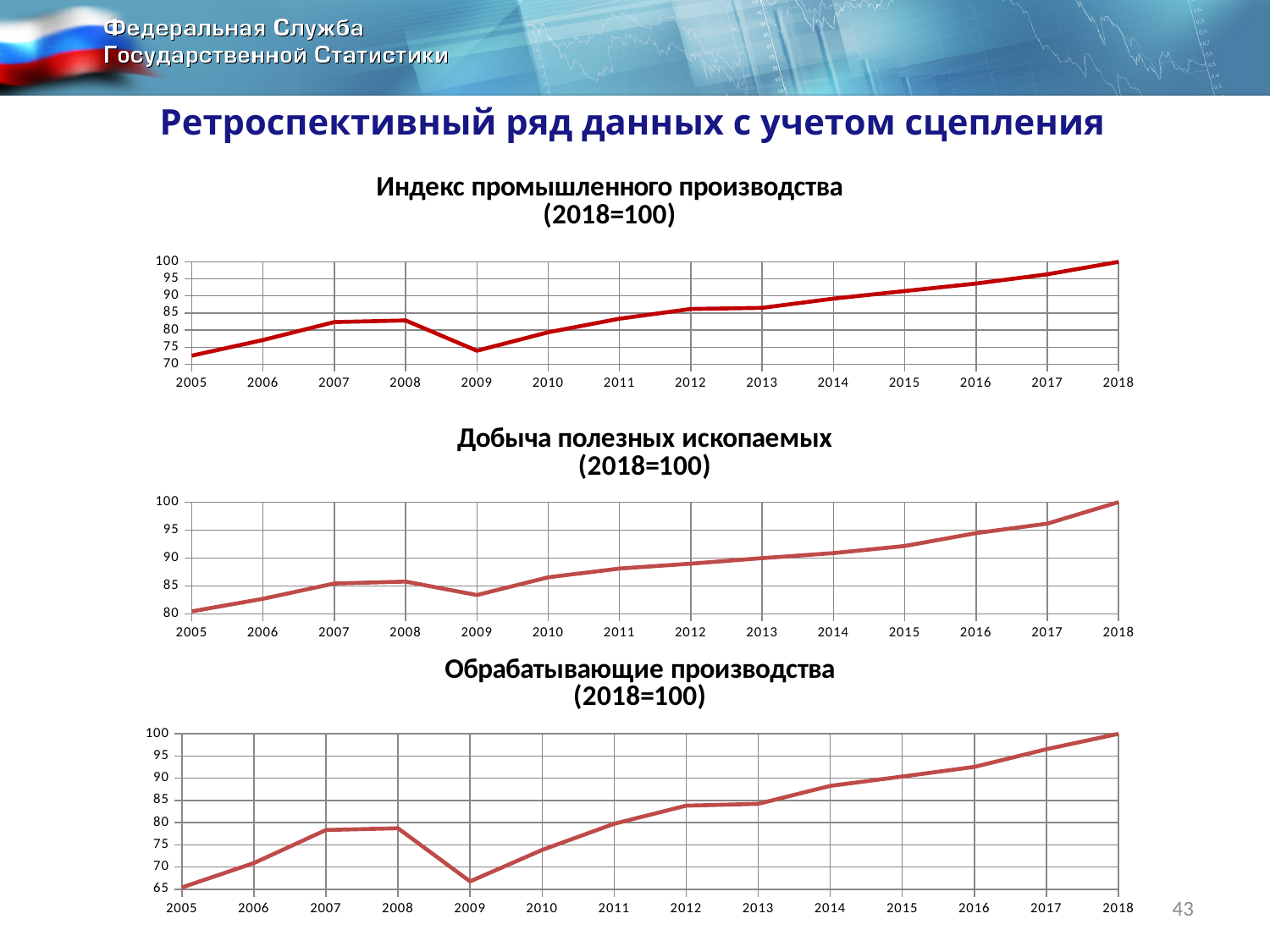
In the top chart "Индекс промышленного производства (2018=100)", is the value for 2009 greater or less than 80? less In the middle chart "Добыча полезных ископаемых (2018=100)", which year has the lowest value? 2005 In the top chart "Индекс промышленного производства (2018=100)", is the value for 2016 greater or less than 90? greater In the bottom chart "Обрабатывающие производства (2018=100)", do the values overall rise or fall from 2005 to 2018? rise How many years are plotted on the x axis of the middle chart "Добыча полезных ископаемых (2018=100)"? 14 In the middle chart "Добыча полезных ископаемых (2018=100)", is the value for 2009 greater or less than 85? less In the bottom chart "Обрабатывающие производства (2018=100)", which is larger, the value for 2008 or the value for 2009? 2008 What kind of chart is the top chart titled "Индекс промышленного производства (2018=100)"? line chart In the top chart "Индекс промышленного производства (2018=100)", what is the value for 2018? 100 In the top chart "Индекс промышленного производства (2018=100)", which year has the highest value? 2018